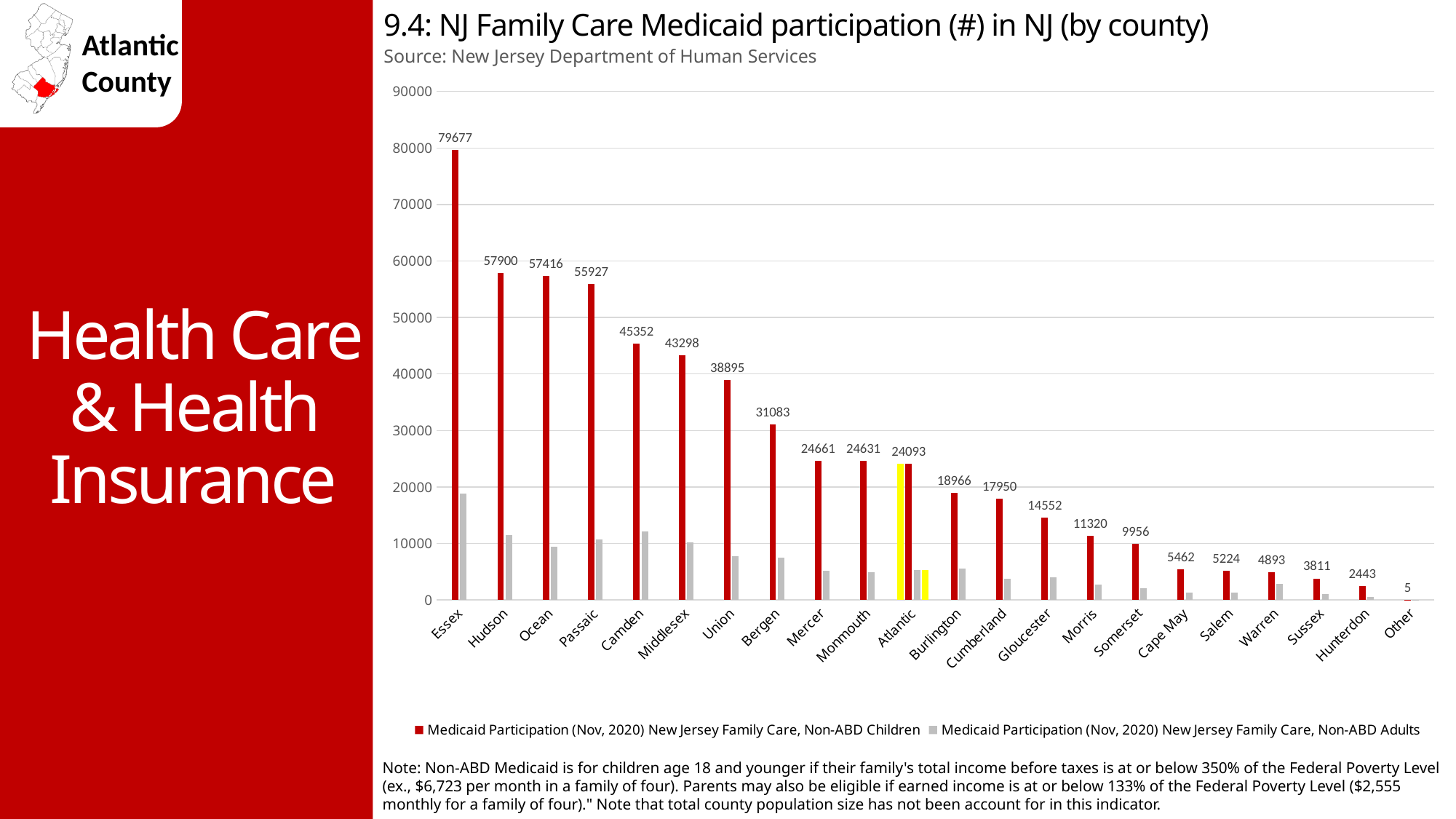
Which has a larger Non-ABD Children value, Bergen or Union? Union How many categories are shown on the x axis? 22 What is the difference between the Non-ABD Children values for Essex and Hudson? 21777 What is the Non-ABD Children Medicaid participation value for Camden? 45352 Which county has the highest Non-ABD Children Medicaid participation? Essex What colour is the Atlantic bar for Non-ABD Children highlighted in? yellow What type of chart is shown on the slide? bar chart Is the Non-ABD Adults value for Essex greater or less than 10000? greater How many series does the legend list? 2 What is the Non-ABD Children Medicaid participation value for Atlantic? 24093 Do the Non-ABD Children values rise or fall moving left to right along the x axis? fall Which category has the lowest Non-ABD Children Medicaid participation? Other